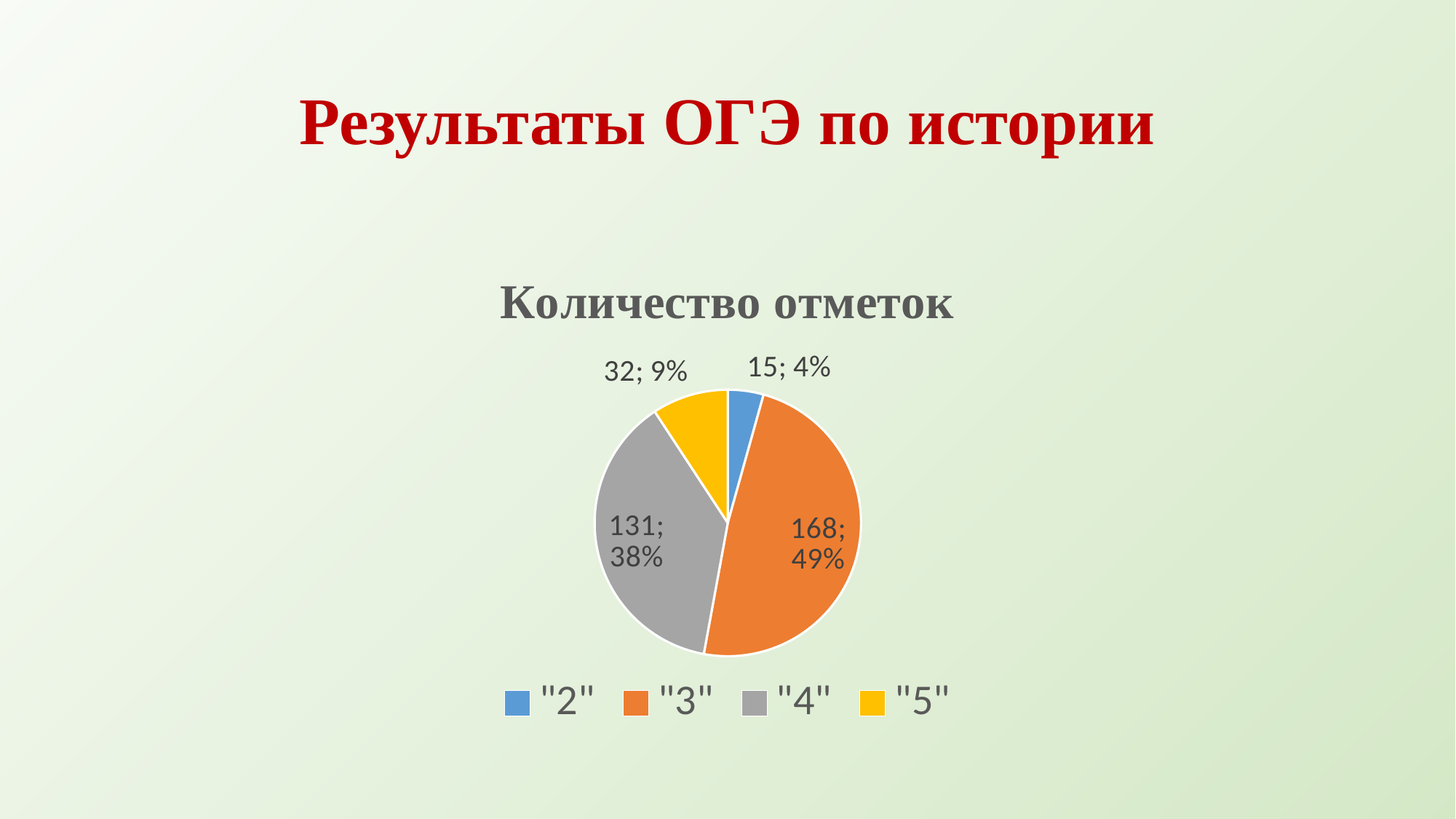
What is the count for the "3" slice? 168 What is the count for the "4" slice? 131 Which grade has the smallest slice? "2" What share of the pie does the "3" slice represent? 49% What is the count for the "2" slice? 15 What kind of chart is shown on the slide? pie chart What is the title of the chart? Количество отметок How many entries does the legend list? 4 What share of the pie does the "5" slice represent? 9% How many slices does the pie chart have? 4 Which grade has the largest slice? "3" What is the difference between the counts for "3" and "4"? 37